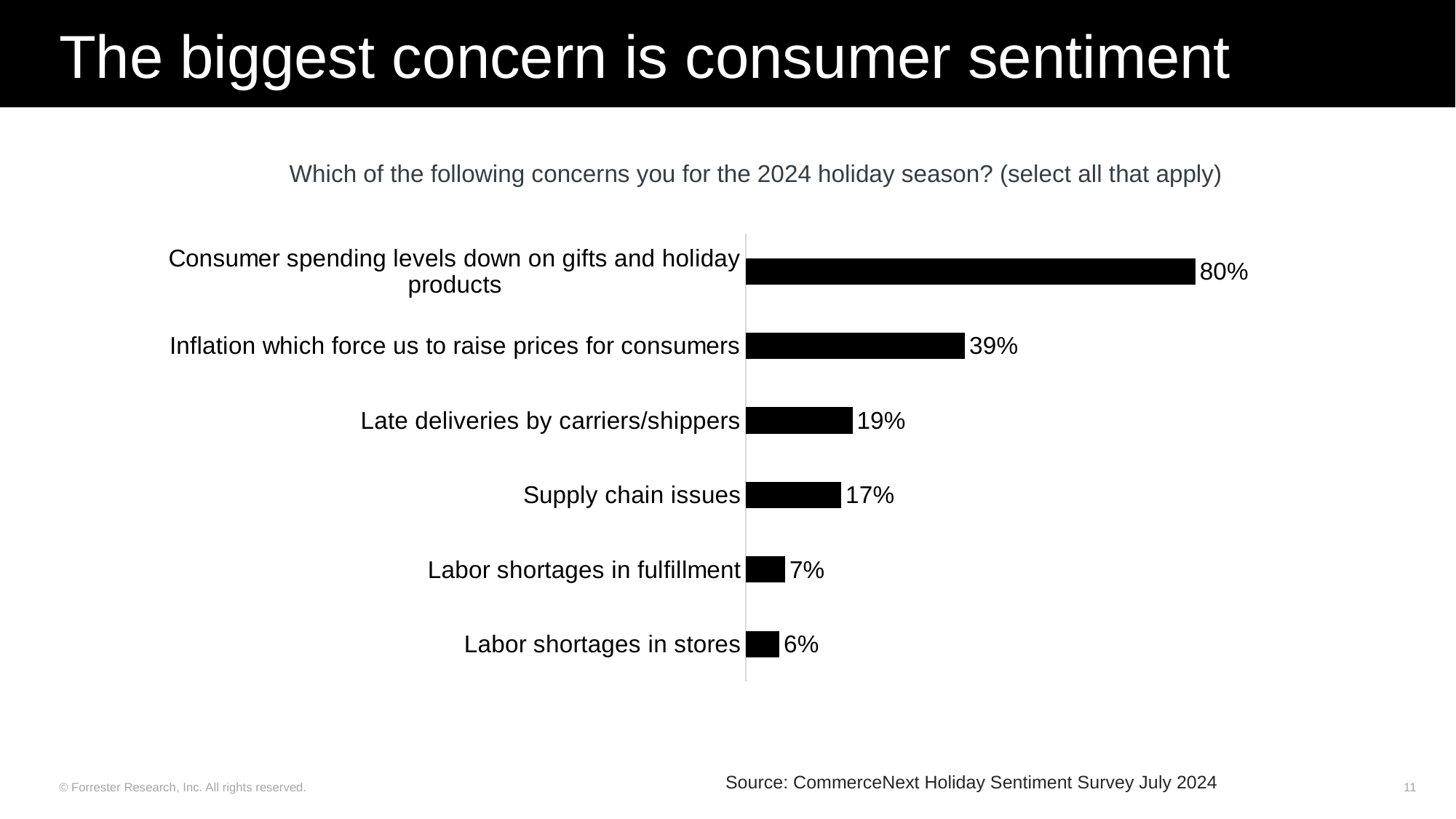
What percentage of respondents selected 'Consumer spending levels down on gifts and holiday products' as a concern? 80% What is the value for 'Supply chain issues'? 17% How many concern categories are shown in the chart? 6 What is the source cited for the chart data? CommerceNext Holiday Sentiment Survey July 2024 Which has a larger value: 'Late deliveries by carriers/shippers' or 'Supply chain issues'? Late deliveries by carriers/shippers Which concern has the lowest percentage? Labor shortages in stores What is the value for 'Labor shortages in stores'? 6% What is the value for 'Late deliveries by carriers/shippers'? 19% Which concern has the highest percentage? Consumer spending levels down on gifts and holiday products What is the value for 'Inflation which force us to raise prices for consumers'? 39% What is the difference between the values for 'Consumer spending levels down on gifts and holiday products' and 'Inflation which force us to raise prices for consumers'? 41% What type of chart is shown on the slide? Bar chart